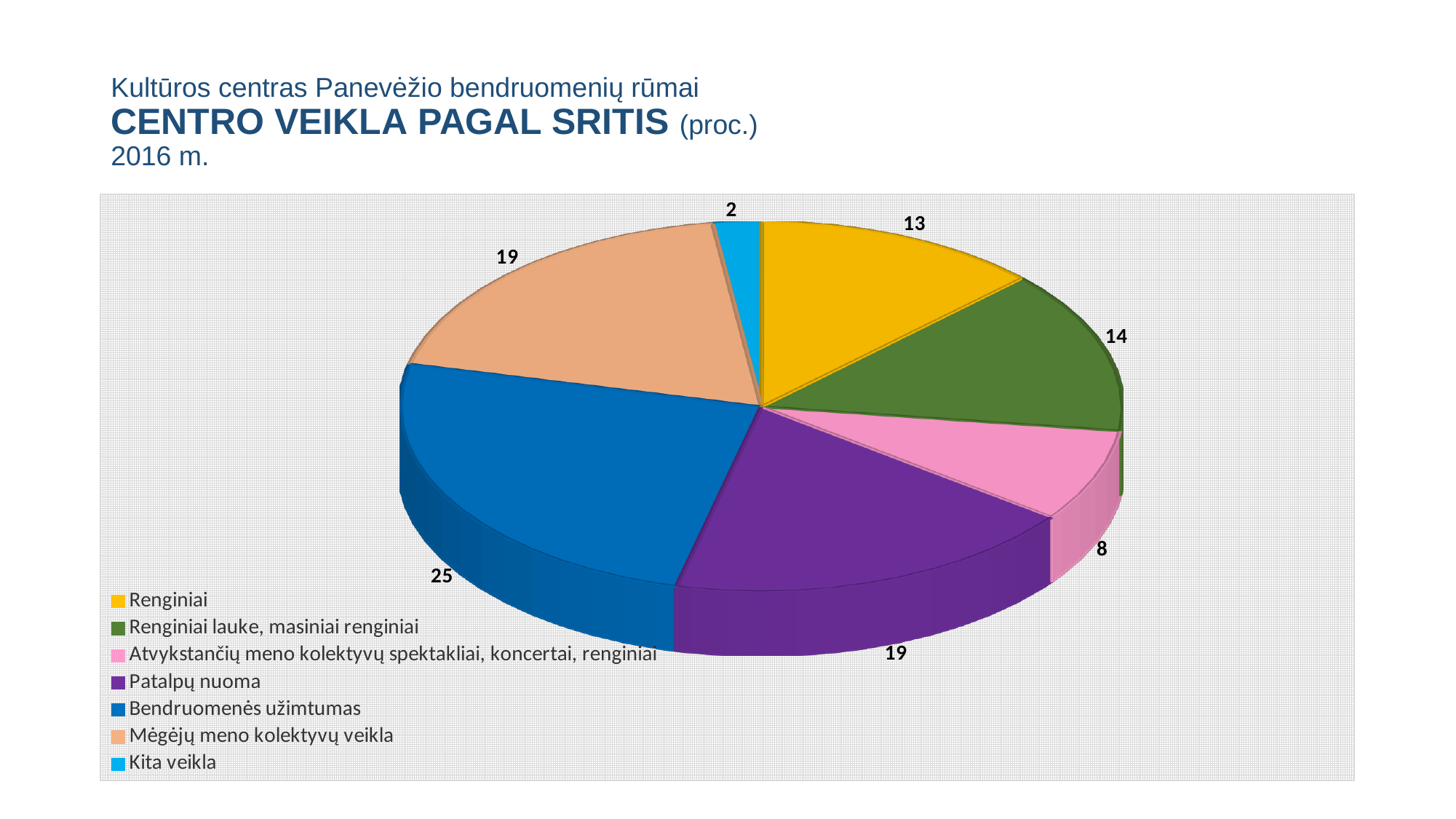
Which is larger, the value for Renginiai lauke, masiniai renginiai or the value for Renginiai? Renginiai lauke, masiniai renginiai Which category has the smallest slice of the pie? Kita veikla What is the value for Atvykstančių meno kolektyvų spektakliai, koncertai, renginiai? 8 What share of the pie does Patalpų nuoma represent? 19% What is the difference between the values for Bendruomenės užimtumas and Renginiai? 12 What kind of chart is shown on the slide? pie chart What is the value for Kita veikla? 2 Which category has the largest slice of the pie? Bendruomenės užimtumas What is the value for Renginiai? 13 What is the value for Bendruomenės užimtumas? 25 What colour is the slice for Mėgėjų meno kolektyvų veikla? light orange (peach) How many categories does the pie chart have? 7